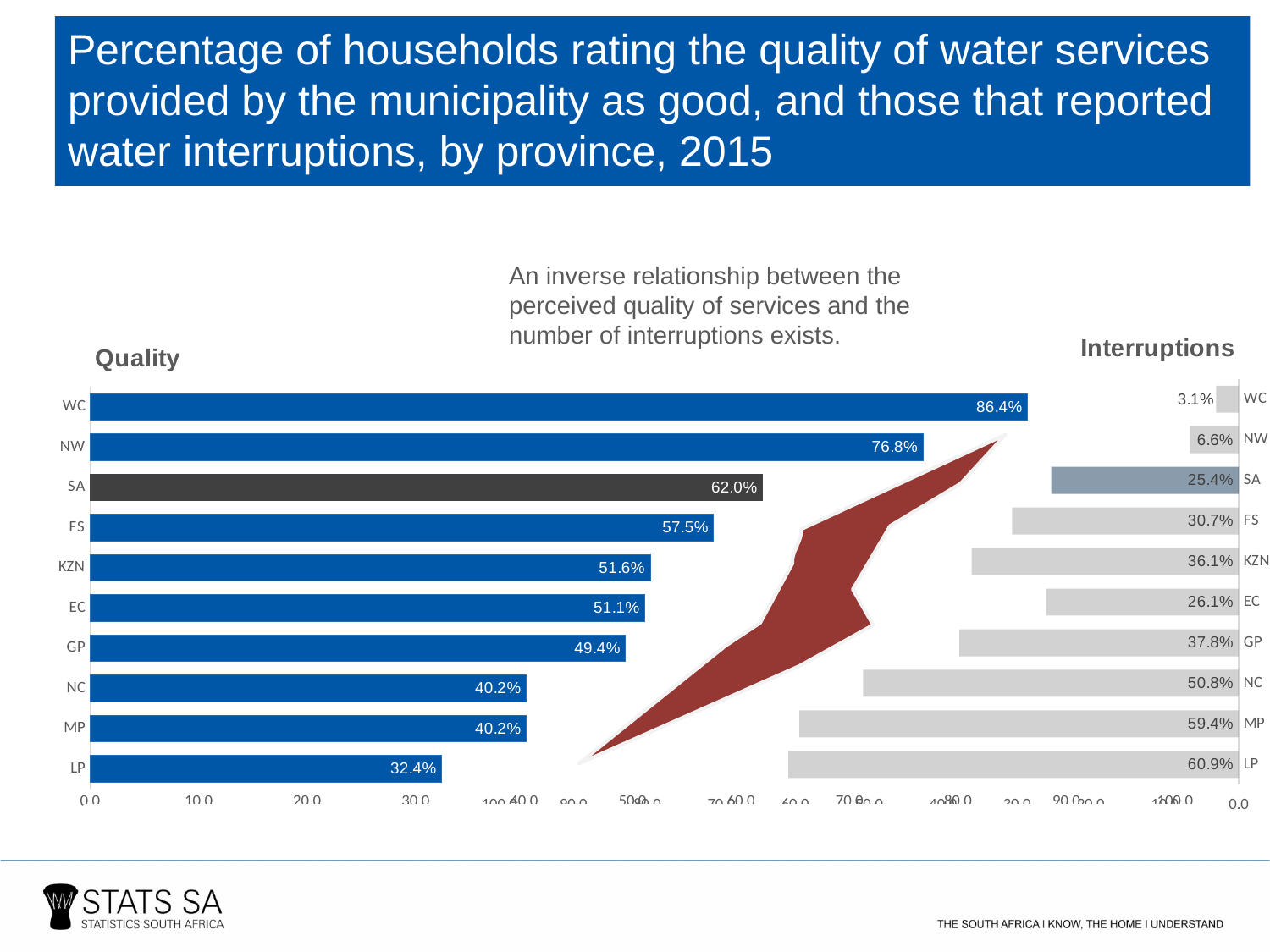
In the Quality chart, what is the difference between the values for WC and NW? 9.6% In the Interruptions chart, which province has the lowest value? WC In the Interruptions chart, which province has the highest value? LP What kind of chart is the Quality chart? Bar chart In the Quality chart, what is the value for SA? 62.0% In the Quality chart, what percentage of households in WC rated the quality of water services as good? 86.4% In the Quality chart, which province has the lowest value? LP In the Interruptions chart, what is the difference between the values for MP and NC? 8.6% In the Interruptions chart, what is the value for KZN? 36.1% How many provinces or categories are shown in the Quality chart? 10 In the Interruptions chart, what percentage of households in LP reported water interruptions? 60.9% In the Quality chart, which is larger, the value for FS or the value for GP? FS